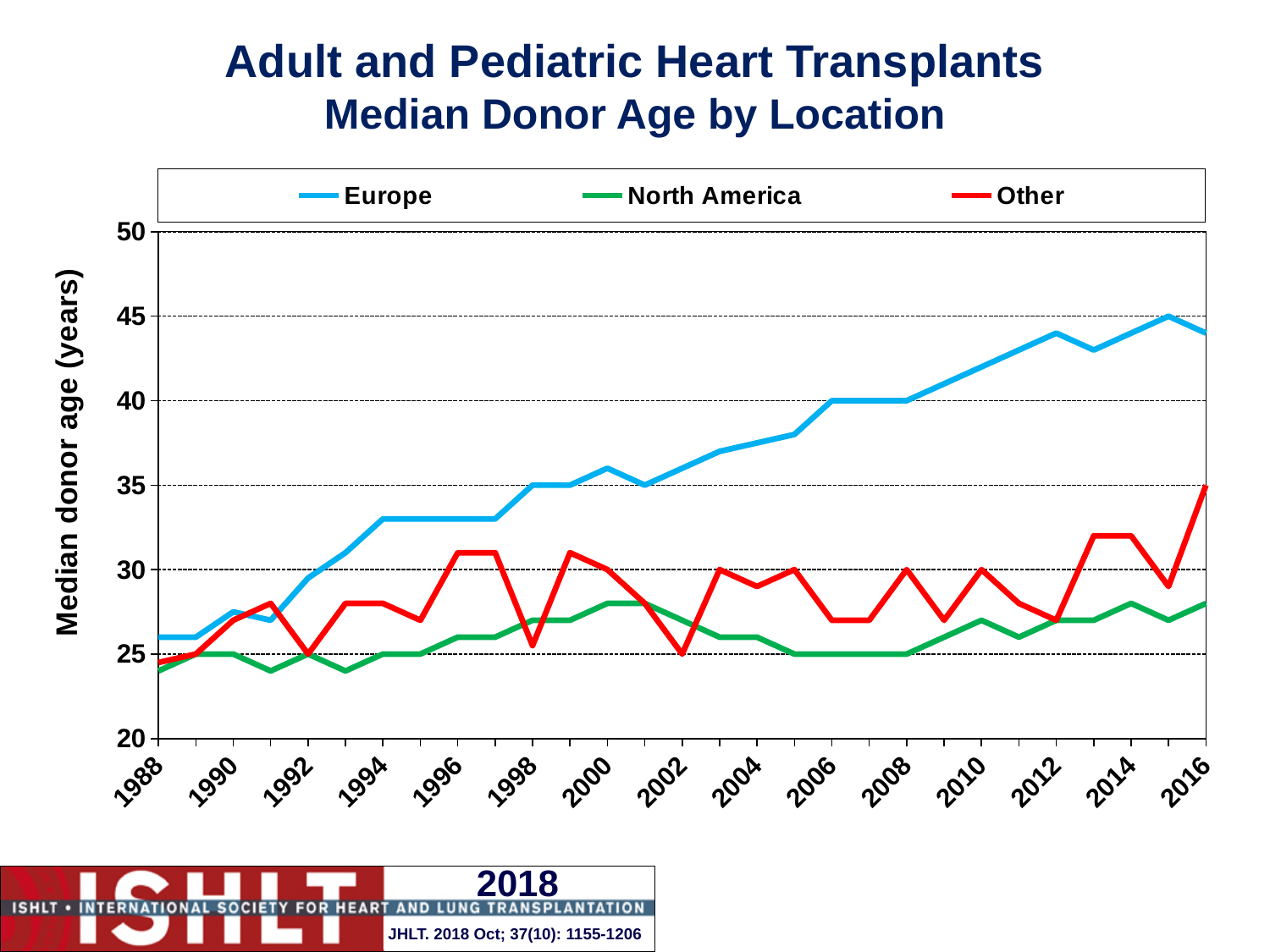
Is the median donor age for Other in 2002 greater or less than 30? less How many series does the legend list? 3 Does the median donor age for Europe generally rise or fall from 1988 to 2016? Rise What is the median donor age for Europe in 2006? 40 Is the median donor age for North America in 2016 greater or less than 30? less Is the median donor age for Europe in 2016 greater or less than 40? greater Which location has the highest median donor age in 2016? Europe What is the label of the vertical axis? Median donor age (years) Which three locations are listed in the legend? Europe, North America, Other What kind of chart is shown on the slide? Line chart In 2010, which has the higher median donor age, Europe or North America? Europe What is the median donor age for Europe in 2015? 45